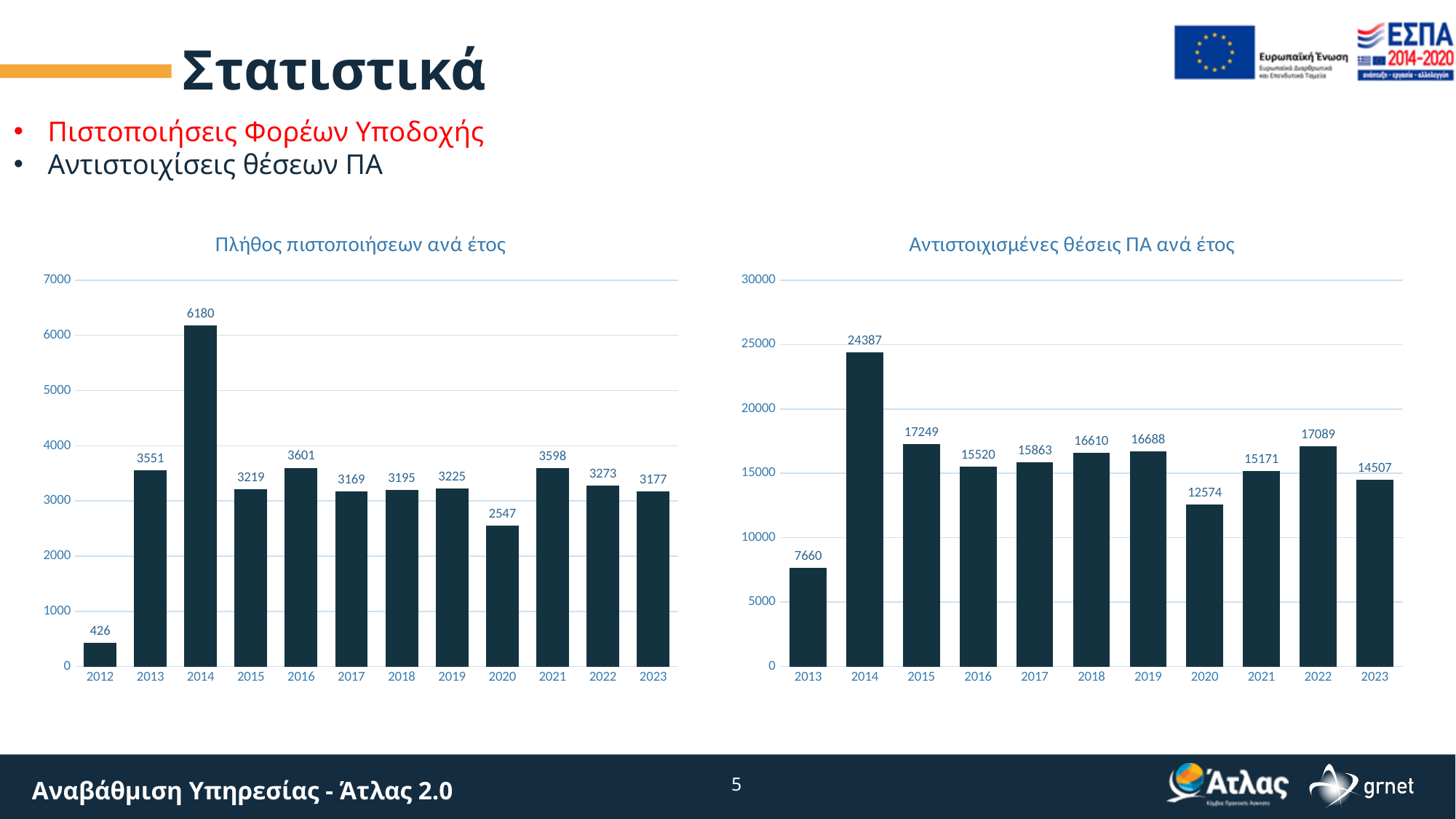
What is the title of the left chart? Πλήθος πιστοποιήσεων ανά έτος In the left chart (Πλήθος πιστοποιήσεων ανά έτος), which year has the lowest value? 2012 In the right chart (Αντιστοιχισμένες θέσεις ΠΑ ανά έτος), which year has the highest value? 2014 In the left chart (Πλήθος πιστοποιήσεων ανά έτος), what is the difference between the values for 2014 and 2013? 2629 In the left chart (Πλήθος πιστοποιήσεων ανά έτος), what is the value for 2014? 6180 What kind of chart is the right chart (Αντιστοιχισμένες θέσεις ΠΑ ανά έτος)? bar chart In the left chart (Πλήθος πιστοποιήσεων ανά έτος), is the value for 2020 greater or less than 3000? less In the right chart (Αντιστοιχισμένες θέσεις ΠΑ ανά έτος), what is the value for 2020? 12574 In the right chart (Αντιστοιχισμένες θέσεις ΠΑ ανά έτος), which is larger, the value for 2022 or the value for 2023? 2022 In the left chart (Πλήθος πιστοποιήσεων ανά έτος), how many years are shown on the x axis? 12 In the right chart (Αντιστοιχισμένες θέσεις ΠΑ ανά έτος), what is the difference between the values for 2014 and 2013? 16727 In the right chart (Αντιστοιχισμένες θέσεις ΠΑ ανά έτος), how many years are shown on the x axis? 11